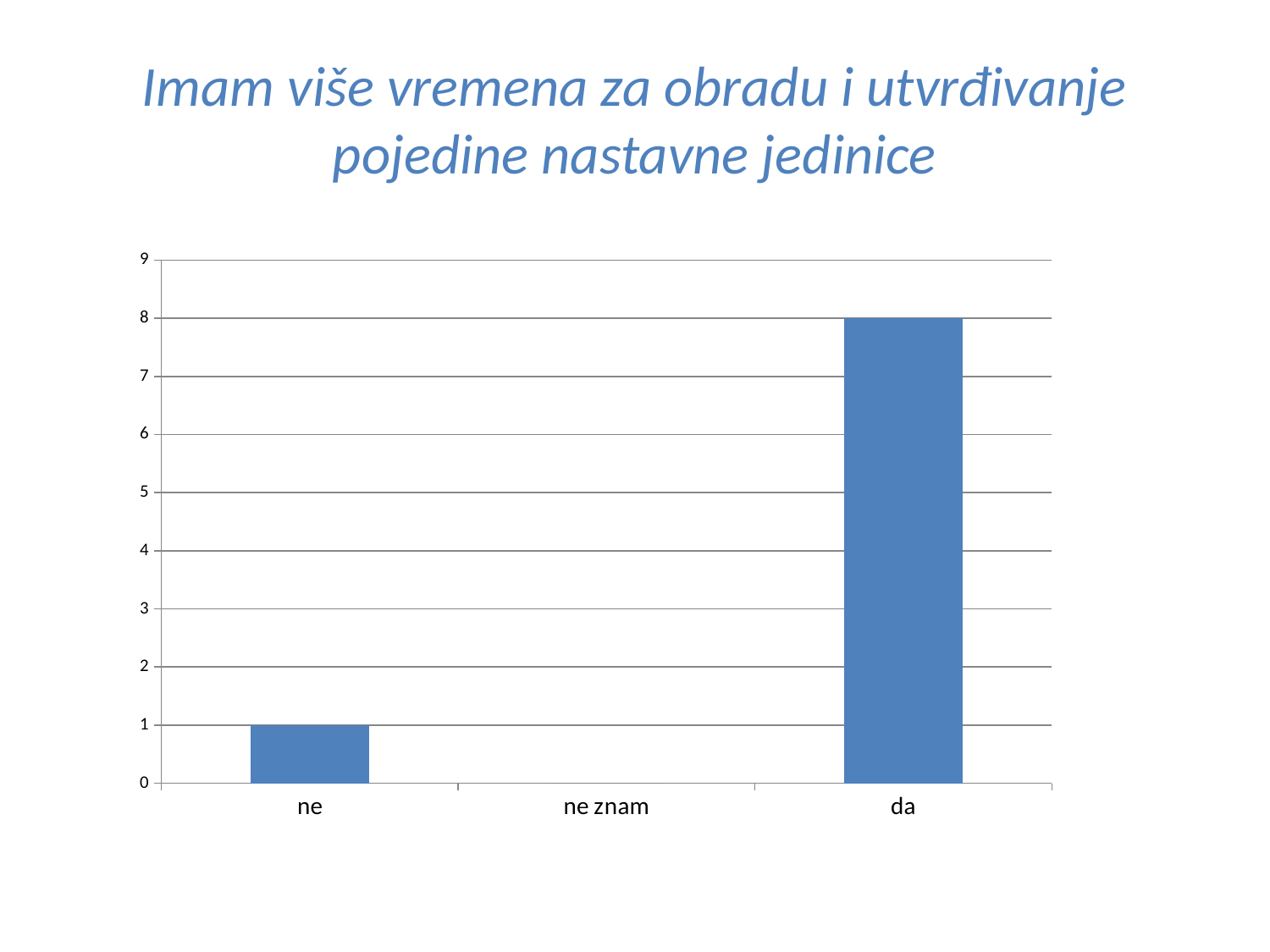
Which category has the highest value? da What is the title of the slide? Imam više vremena za obradu i utvrđivanje pojedine nastavne jedinice What is the value for "ne znam"? 0 What kind of chart is shown on the slide? bar chart Which is larger, the value for "ne" or the value for "da"? da What is the value for "da"? 8 Is the value for "da" greater or less than 5? greater What is the difference between the values for "da" and "ne"? 7 How many categories are shown on the x axis? 3 Is the value for "ne" greater or less than 4? less Which category has the lowest value? ne znam What is the value for "ne"? 1